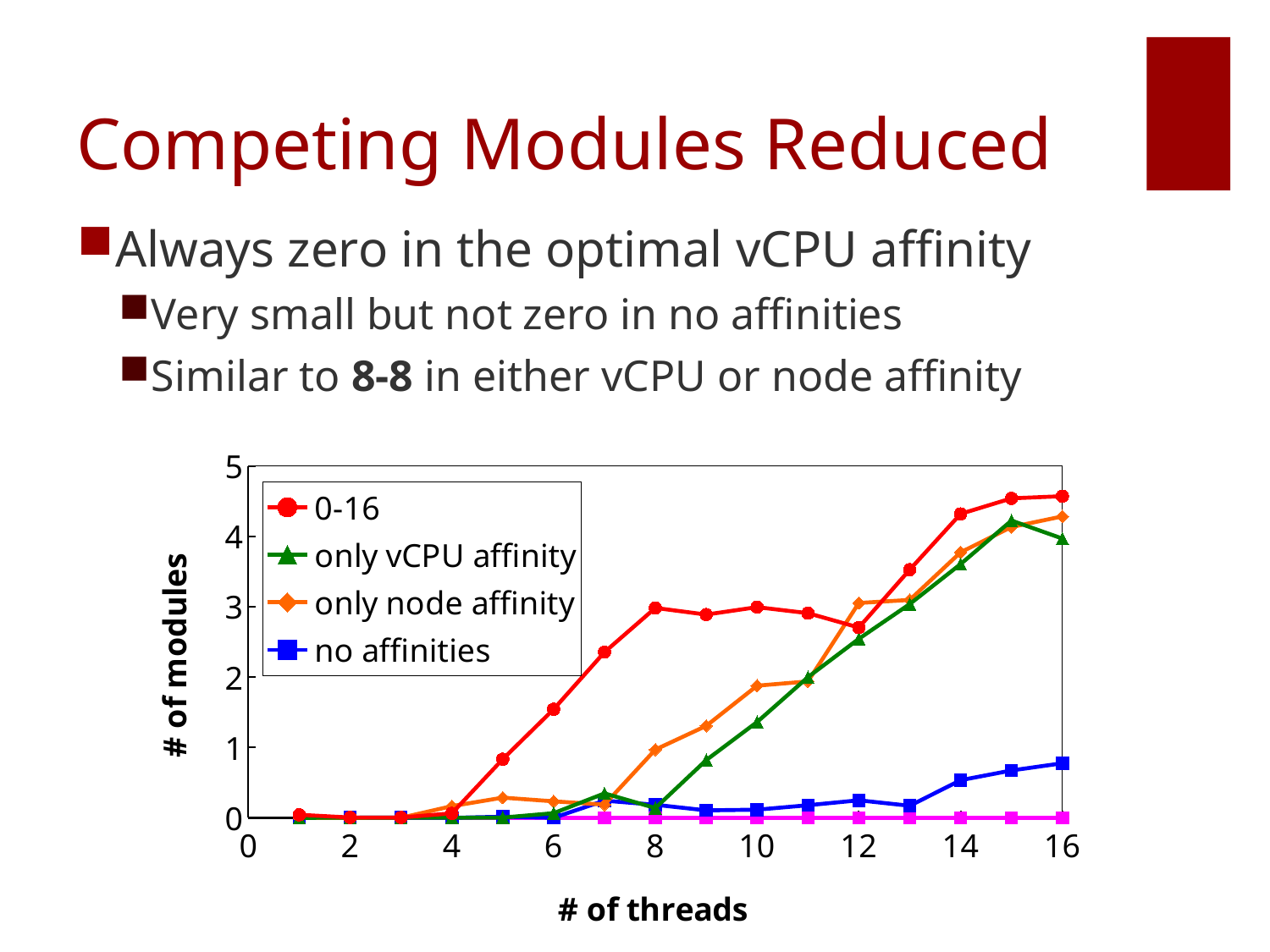
At 10 threads, which series has the larger value: 0-16 or only vCPU affinity? 0-16 What is the label of the y axis? # of modules What is the label of the x axis? # of threads Is the value for the 0-16 series at 16 threads greater or less than 4? greater How many series does the legend list? 4 Does the 0-16 series rise or fall between 4 and 8 threads? rise Which legend series has the lowest value at 16 threads? no affinities Is the value for the no affinities series at 16 threads greater or less than 1? less What kind of chart is shown on the slide? line chart Is the value for the only vCPU affinity series at 12 threads greater or less than 2? greater Which legend series has the highest value at 16 threads? 0-16